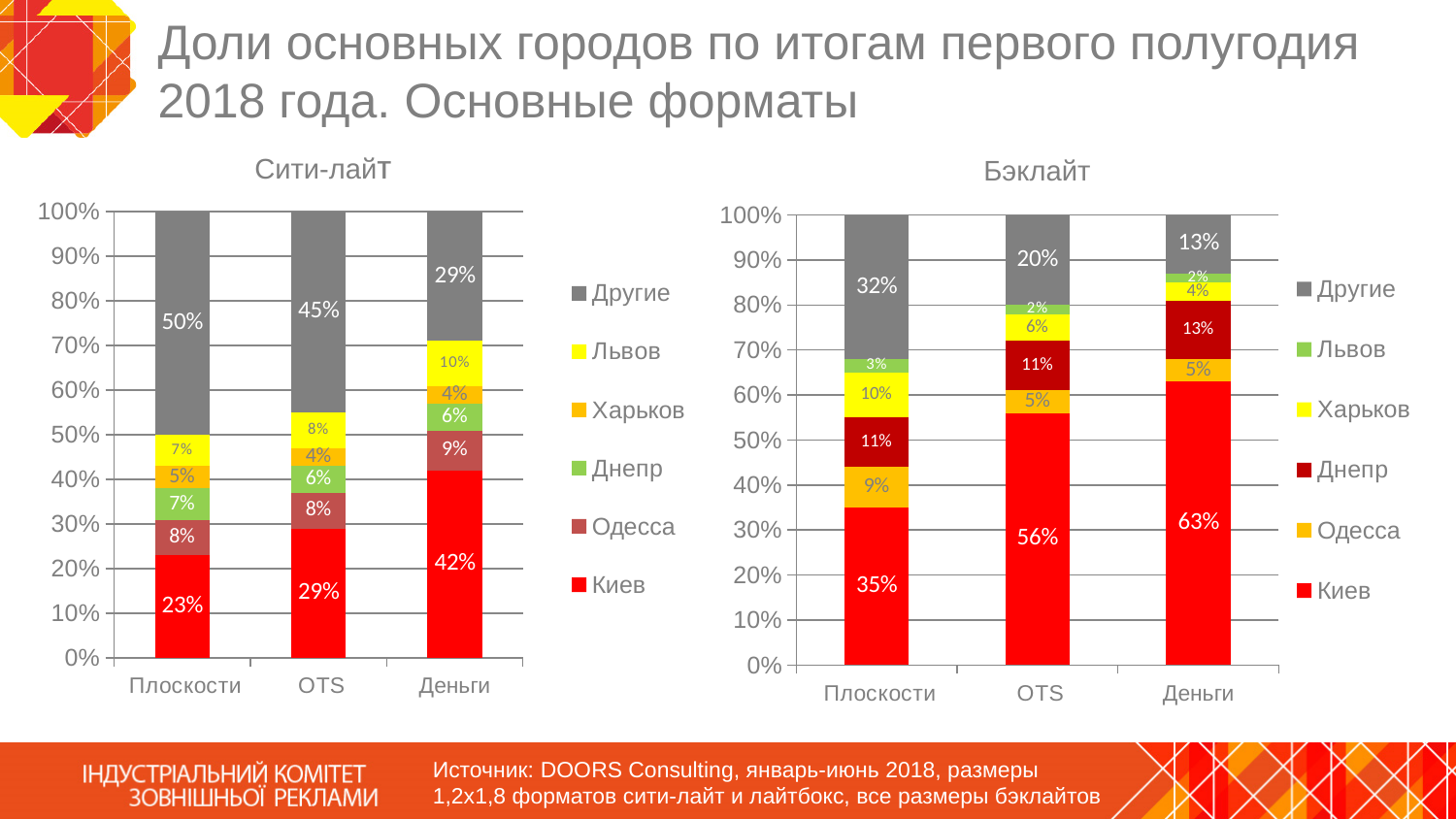
In the Сити-лайт chart, which category has the lowest value for Другие? Деньги How many categories are shown on the x axis of the Бэклайт chart? 3 In the Бэклайт chart, does the value for Киев rise or fall from Плоскости to Деньги? Rise In the Бэклайт chart, what is the value for Днепр in the Деньги bar? 13% In the Бэклайт chart, which category has the highest value for Киев? Деньги In the Бэклайт chart, what is the value for Другие in the Плоскости bar? 32% In the Сити-лайт chart, what is the value for Киев in the Деньги bar? 42% How many series does the legend of the Сити-лайт chart list? 6 In the Сити-лайт chart, what is the value for Львов in the OTS bar? 8% What kind of chart is the Сити-лайт chart? Stacked bar chart In the Бэклайт chart, which is larger: Киев for OTS or Киев for Плоскости? Киев for OTS In the Сити-лайт chart, what is the difference between the Другие values for Плоскости and Деньги? 21%